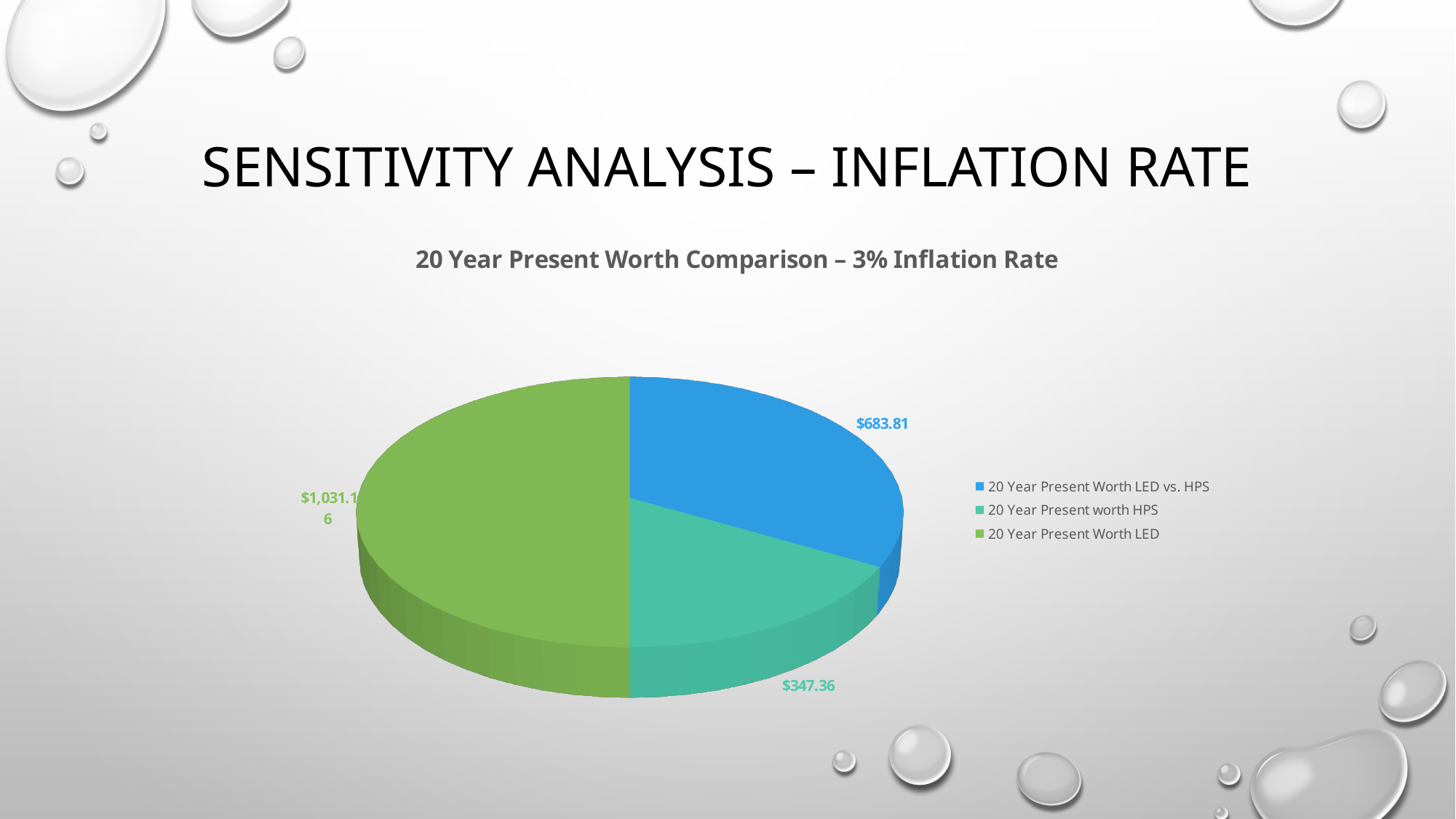
What is the difference between the 20 Year Present Worth LED value and the 20 Year Present worth HPS value? $683.80 What is the title of the chart? 20 Year Present Worth Comparison – 3% Inflation Rate Which slice of the pie has the smallest value? 20 Year Present worth HPS What is the value shown for 20 Year Present Worth LED? $1,031.16 How many slices does the pie chart have? 3 What is the value shown for 20 Year Present worth HPS? $347.36 Which is larger: the value for 20 Year Present Worth LED vs. HPS or the value for 20 Year Present worth HPS? 20 Year Present Worth LED vs. HPS Which slice of the pie has the largest value? 20 Year Present Worth LED What is the value shown for 20 Year Present Worth LED vs. HPS? $683.81 How many entries does the legend list? 3 What type of chart is shown on the slide? Pie chart What colour is the slice for 20 Year Present Worth LED? Green